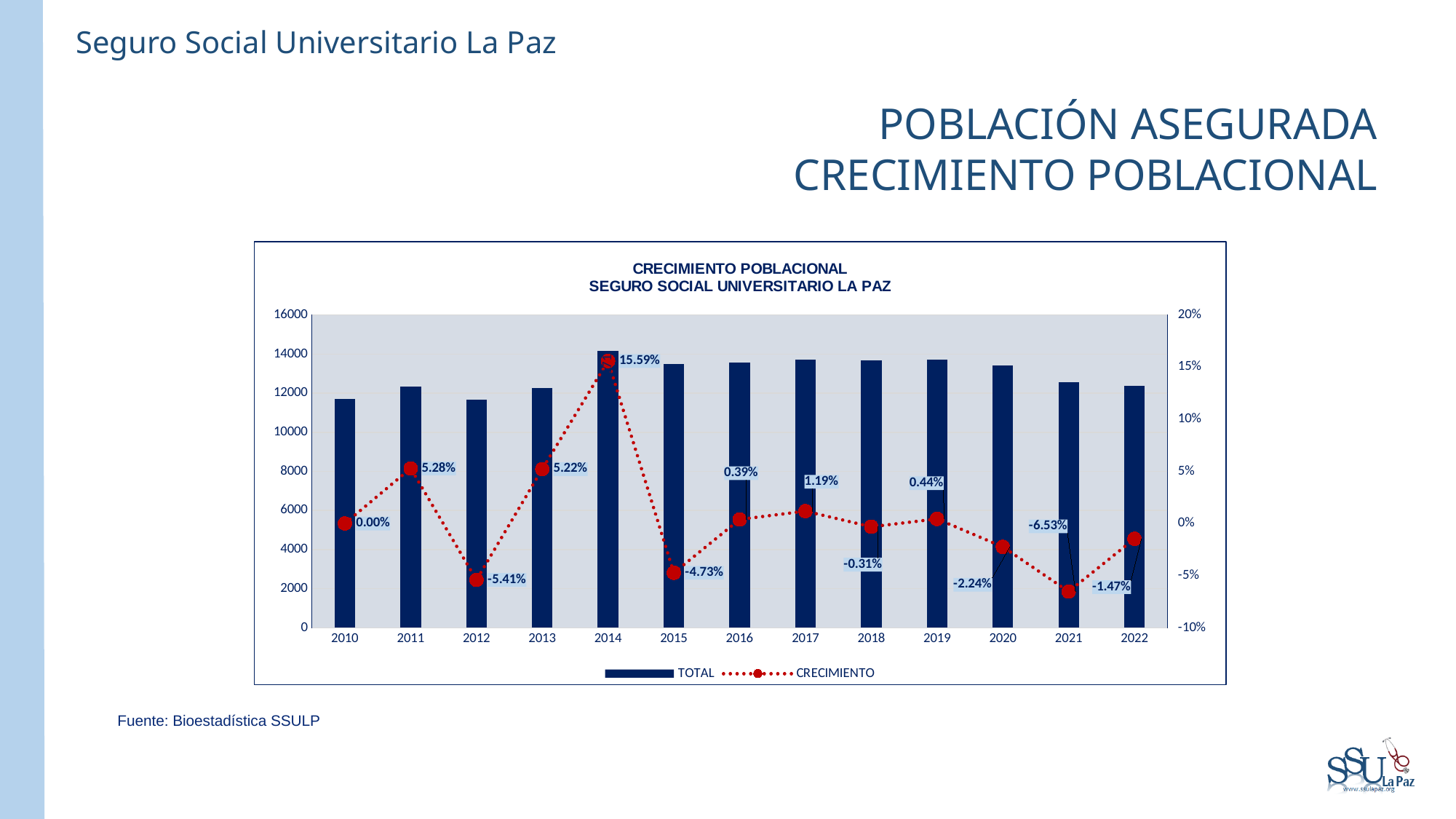
What kind of chart is this? Combined bar and line chart What is the CRECIMIENTO value for 2014? 15.59% Is the TOTAL value for 2010 greater or less than 12000? less What is the difference between the CRECIMIENTO values for 2011 and 2012? 10.69 percentage points Which year has the lowest CRECIMIENTO value? 2021 Which year has the highest CRECIMIENTO value? 2014 How many series does the legend list? 2 What is the CRECIMIENTO value for 2017? 1.19% Which year has a larger CRECIMIENTO value, 2013 or 2016? 2013 How many years are shown on the x axis? 13 Is the TOTAL value for 2017 greater or less than 12000? greater What is the CRECIMIENTO value for 2021? -6.53%